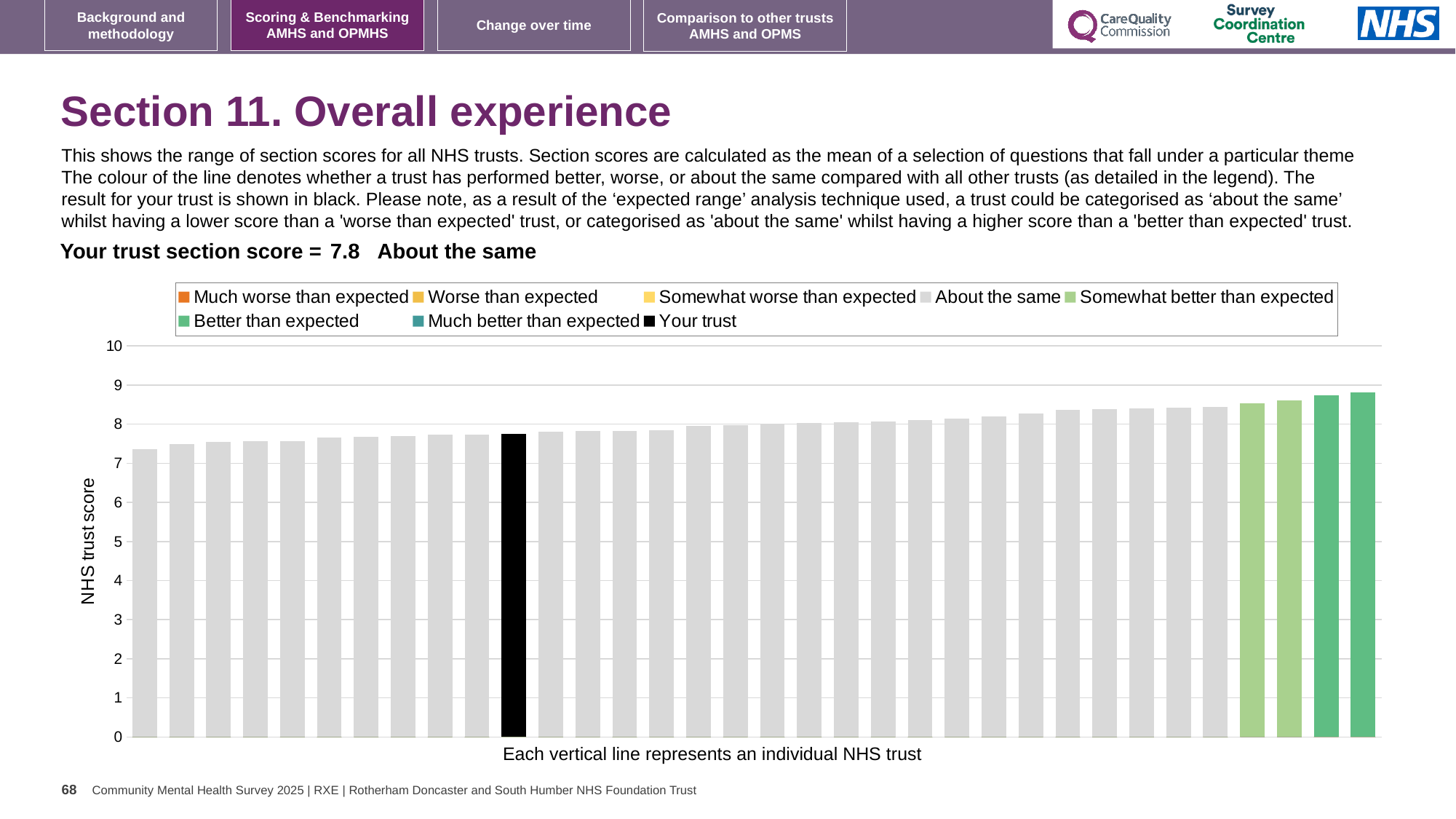
Which performance category is your trust placed in for Section 11? About the same How many entries does the chart legend list? 8 Is the value of the black 'Your trust' bar greater or less than 5? greater Is the value of the leftmost (lowest) bar greater or less than 7? greater What colour is the bar representing your trust? black What kind of chart is shown on the slide? bar chart How many bars are coloured in the 'Somewhat better than expected' (light green) colour? 2 What is the section score for your trust shown on the slide? 7.8 Is the value of the rightmost (highest) bar greater or less than 9? less Do the bar values rise or fall from left to right along the x axis? rise How many bars are coloured in the 'Better than expected' (darker green) colour? 2 What is the label on the vertical axis of the chart? NHS trust score